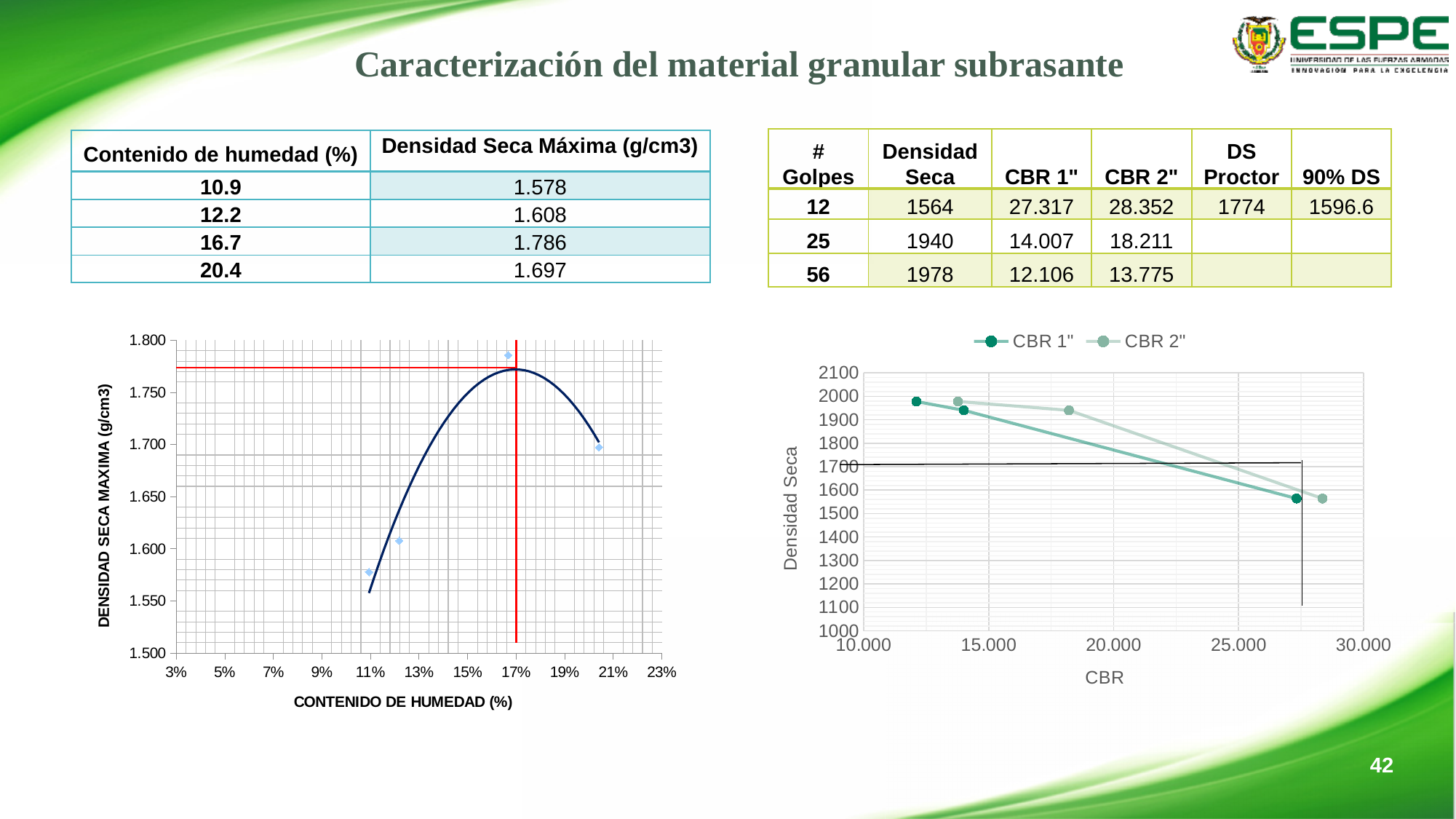
On the left chart, is the density value at about 17% moisture content greater or less than 1.750? greater What are the legend entries of the right chart? CBR 1" and CBR 2" What kind of chart is the right chart (Densidad Seca vs CBR)? line chart How many series does the legend of the right chart list? 2 On the right chart, at a Densidad Seca of 1940, which series has the larger CBR value, CBR 1" or CBR 2"? CBR 2" How many data points does the CBR 1" series have on the right chart? 3 How many data points are plotted on the left chart? 4 On the right chart, does Densidad Seca rise or fall as CBR increases along the x axis? fall What is the x-axis title of the left chart? CONTENIDO DE HUMEDAD (%) On the right chart, is the Densidad Seca of the CBR 1" point near CBR 27 greater or less than 1600? less On the left chart, is the density value at about 11% moisture content greater or less than 1.600? less What kind of chart is the left chart (Densidad Seca Máxima vs Contenido de Humedad)? scatter chart with a fitted curve